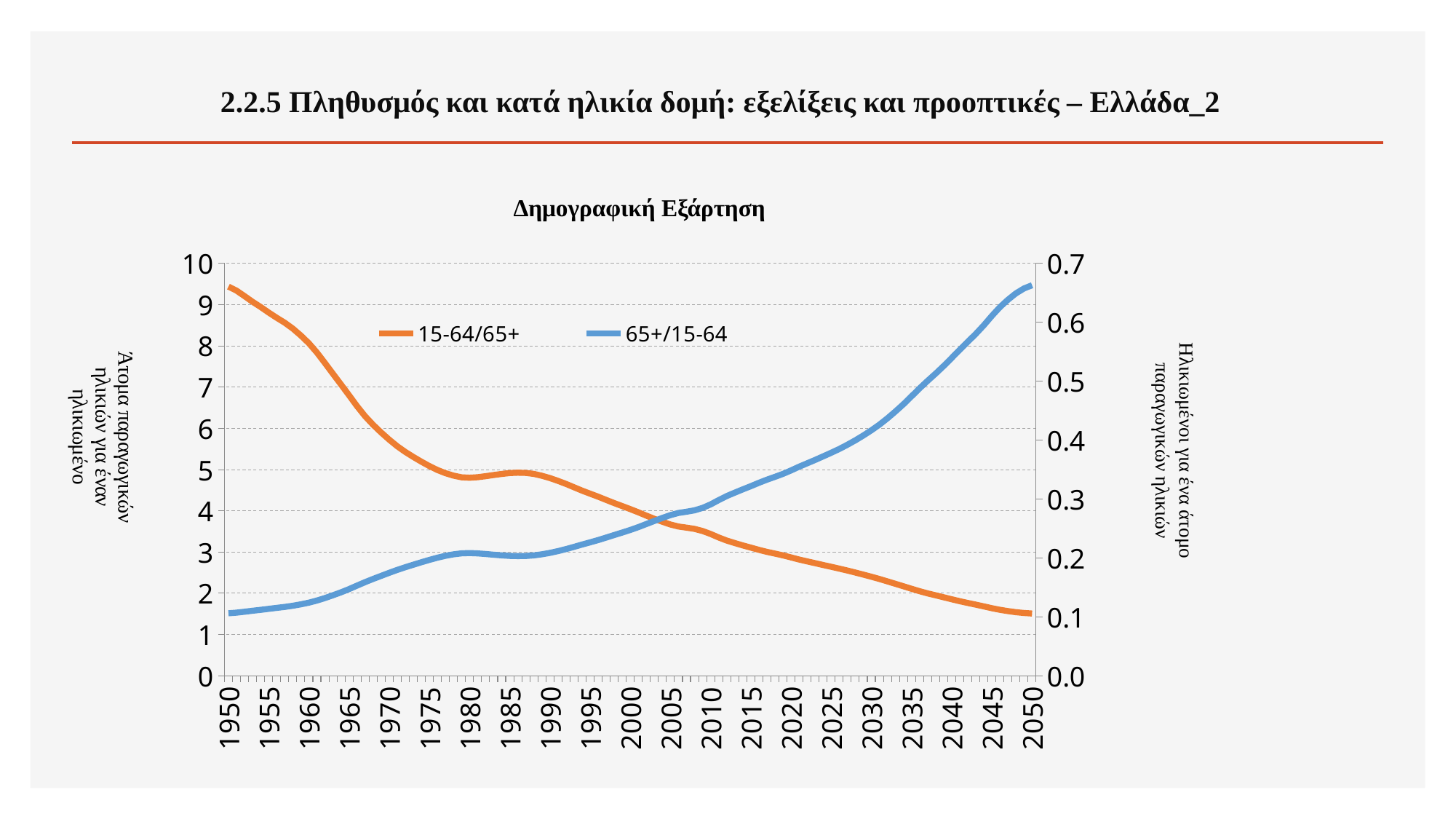
What is the title of the chart? Δημογραφική Εξάρτηση How many years are labelled along the x axis? 21 Which series is drawn in orange? 15-64/65+ What kind of chart is shown on the slide? line chart Is the value for 65+/15-64 in 2050 greater or less than 0.6? greater Is the value for 15-64/65+ in 2050 greater or less than 2? less Is the value for 15-64/65+ in 1950 greater or less than 9? greater Does the 15-64/65+ series rise or fall from 1950 to 2050? fall In which year is the 15-64/65+ series highest? 1950 How many series does the legend list? 2 Does the 65+/15-64 series rise or fall from 1950 to 2050? rise In which year is the 65+/15-64 series highest? 2050